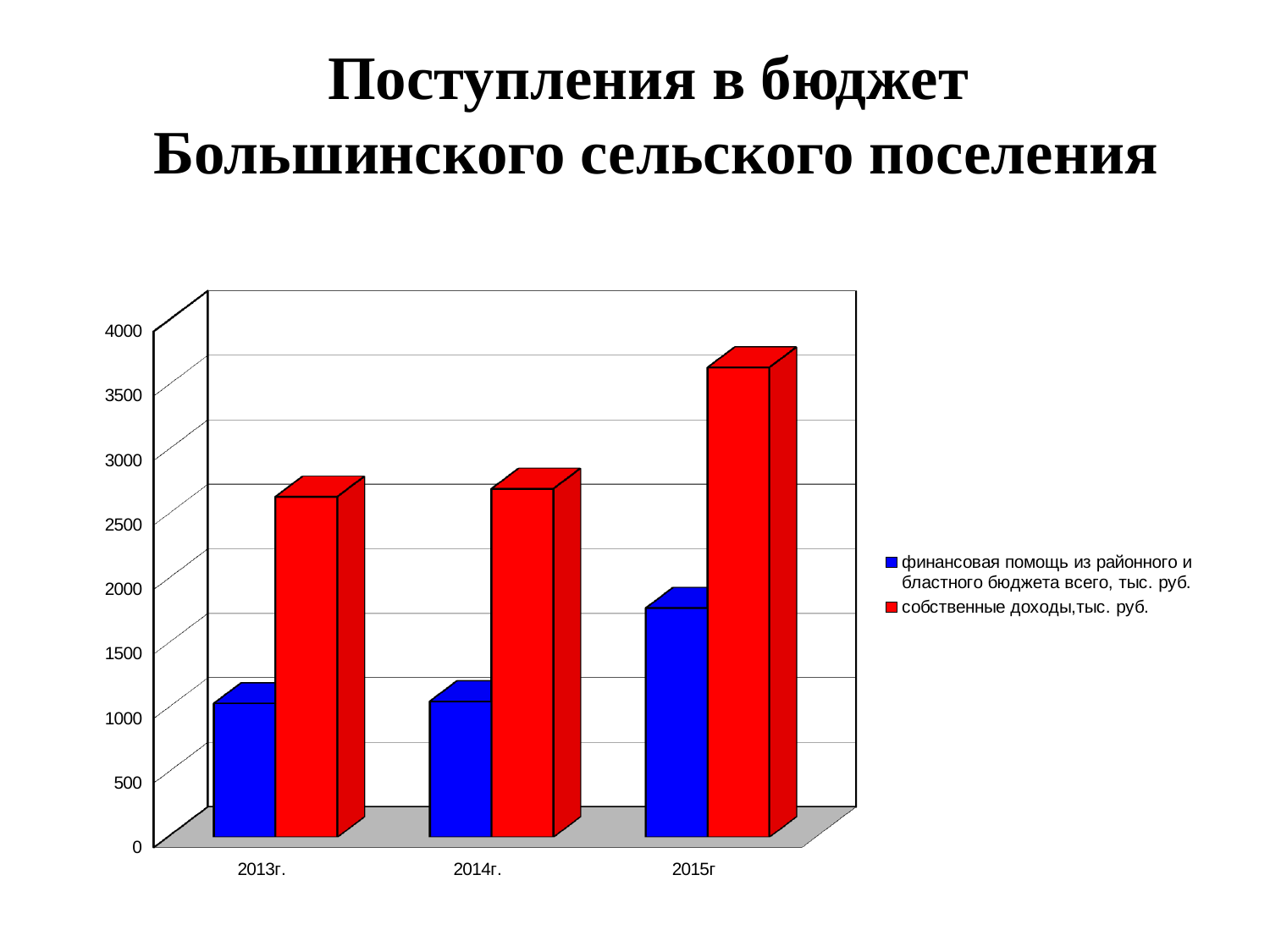
Is the value for 'собственные доходы' in 2015г greater or less than 3000? greater In which year is the value for 'финансовая помощь из районного и бластного бюджета всего, тыс. руб.' the highest? 2015г What colour represents 'собственные доходы,тыс. руб.' in the chart? red In 2013г., which is larger: 'собственные доходы' or 'финансовая помощь из районного и бластного бюджета'? собственные доходы How many series does the chart legend list? 2 How many years (categories) are shown on the x axis of the chart? 3 Is the value for 'финансовая помощь из районного и бластного бюджета' in 2015г greater or less than 1500? greater Is the value for 'финансовая помощь из районного и бластного бюджета' in 2013г. greater or less than 1500? less Do the values for 'собственные доходы' rise or fall from 2013г. to 2015г? rise In which year is the value for 'собственные доходы,тыс. руб.' the highest? 2015г What kind of chart is shown on the slide? bar chart